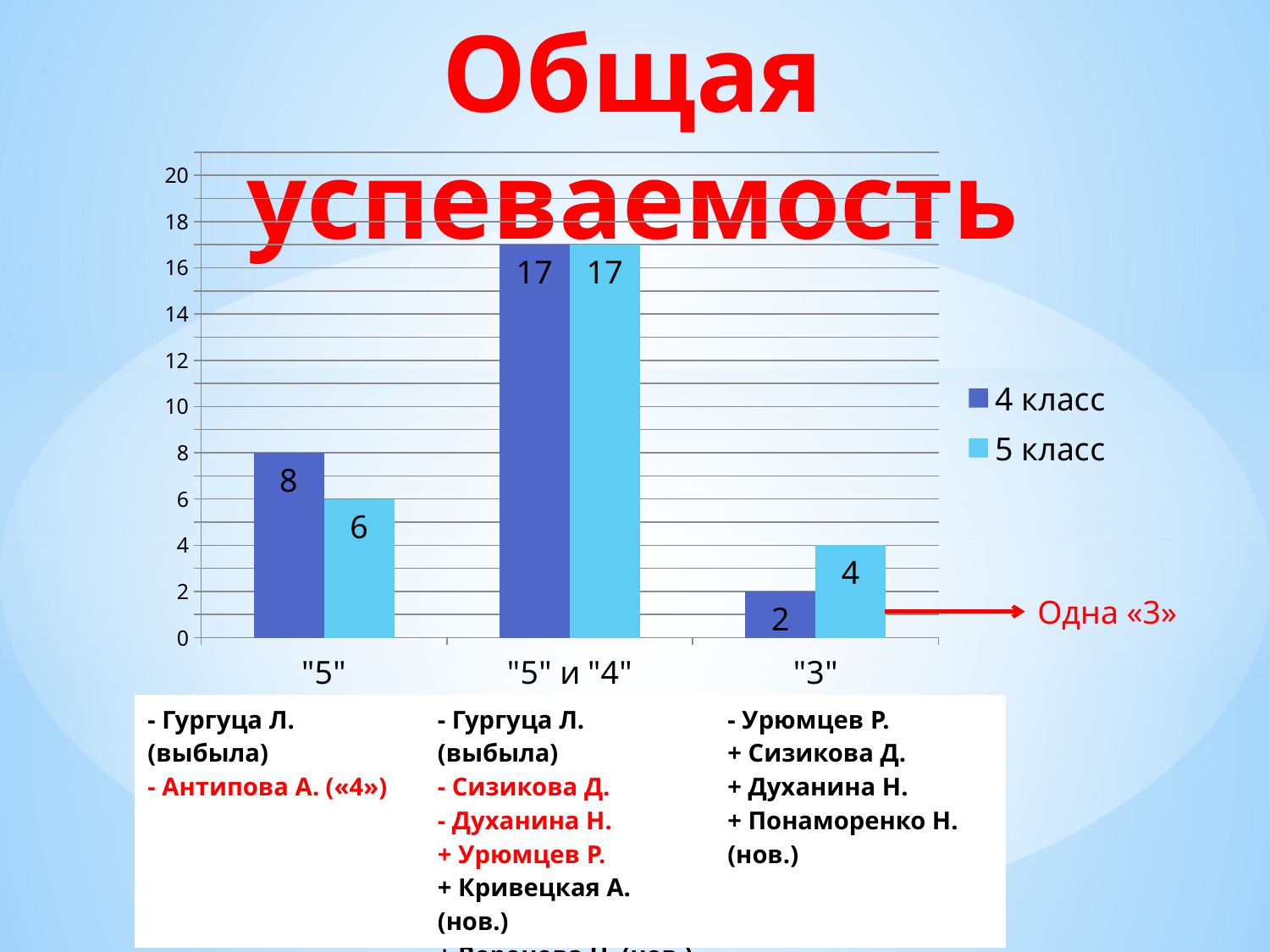
How many categories are shown on the x axis? 3 What is the value for "5" in the 5 класс series? 6 What is the value for "5" in the 4 класс series? 8 Which category has the highest value in the 4 класс series? "5" и "4" What kind of chart is shown on the slide? bar chart Which category has the lowest value in the 5 класс series? "3" What is the value for "3" in the 5 класс series? 4 What is the difference between the 4 класс and 5 класс values for "5"? 2 Which is larger for "3": the 4 класс value or the 5 класс value? 5 класс What is the value for "5" и "4" in the 4 класс series? 17 Is the value for "5" и "4" in the 5 класс series greater or less than 10? greater How many series does the legend list? 2